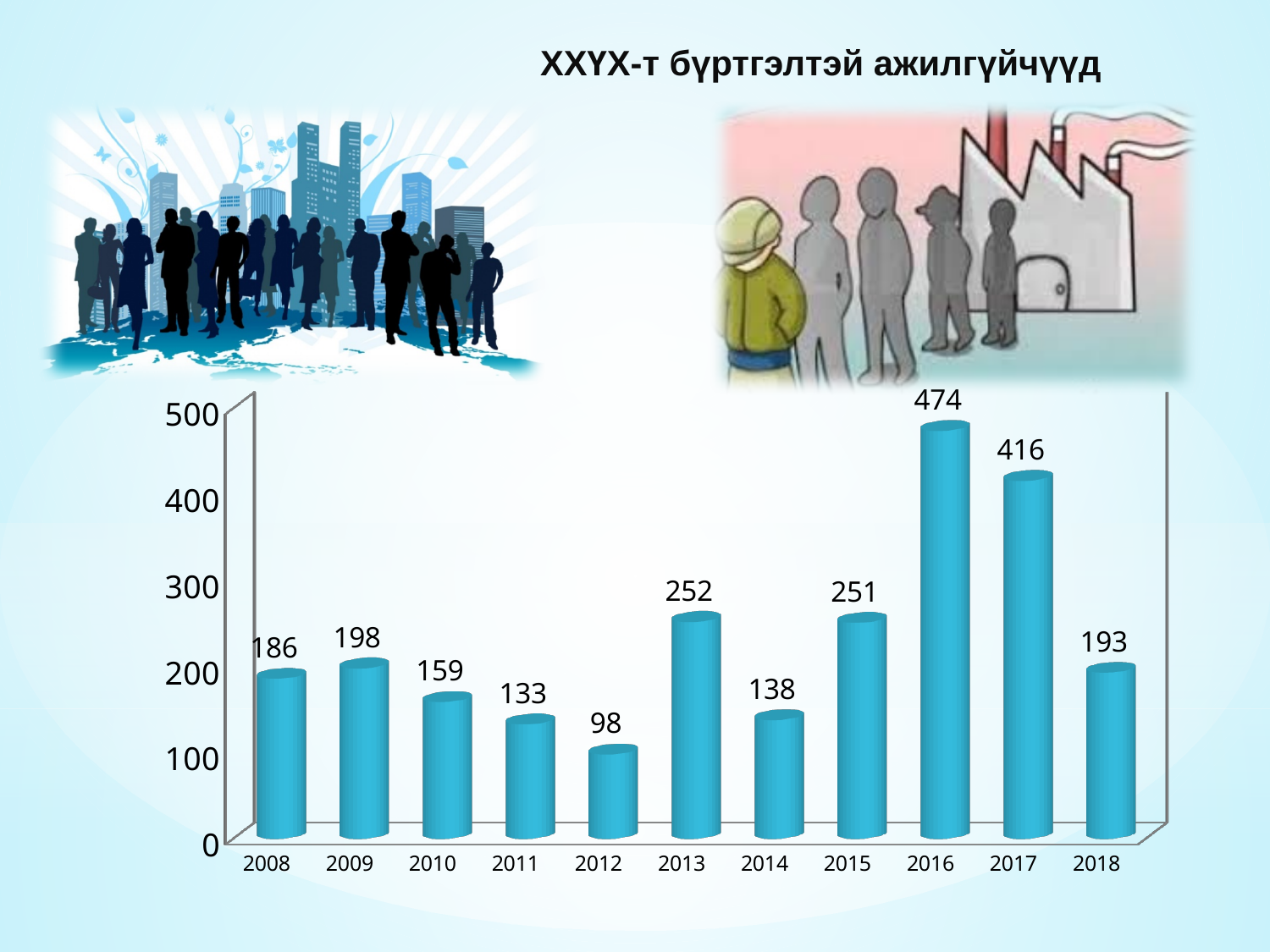
Is the value for 2014 greater or less than 200? less What is the difference between the values for 2018 and 2008? 7 Which year has the highest value? 2016 What is the value for 2016? 474 What is the value for 2010? 159 Which is larger, the value for 2009 or the value for 2011? 2009 What is the value for 2012? 98 What kind of chart is shown on the slide? bar chart What is the difference between the values for 2016 and 2017? 58 Which year has the lowest value? 2012 Do the values rise or fall from 2016 to 2018? fall How many years are shown on the x axis? 11